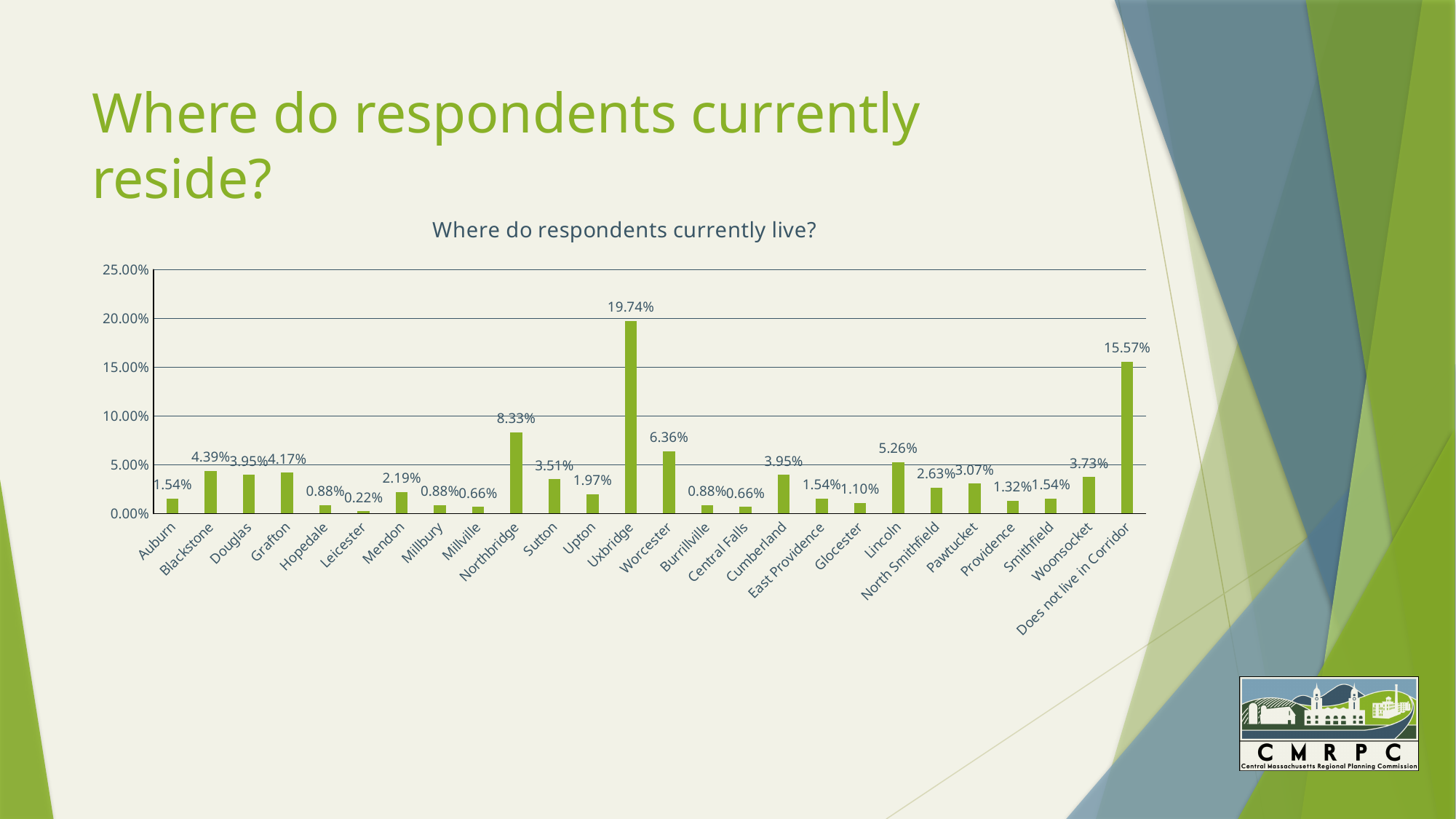
What percentage of respondents do not live in the Corridor? 15.57% Which category has the lowest value in the chart? Leicester Which category has the highest value in the chart? Uxbridge How many categories are shown on the x axis of the chart? 26 Which has a larger value, Worcester or Lincoln? Worcester What is the difference between the values for Northbridge and Worcester? 1.97% What is the value shown for Northbridge? 8.33% What is the difference between the values for Uxbridge and Does not live in Corridor? 4.17% What is the title of the chart? Where do respondents currently live? What type of chart is shown on the slide? Bar chart What percentage of respondents live in Uxbridge? 19.74% What is the value shown for Lincoln? 5.26%